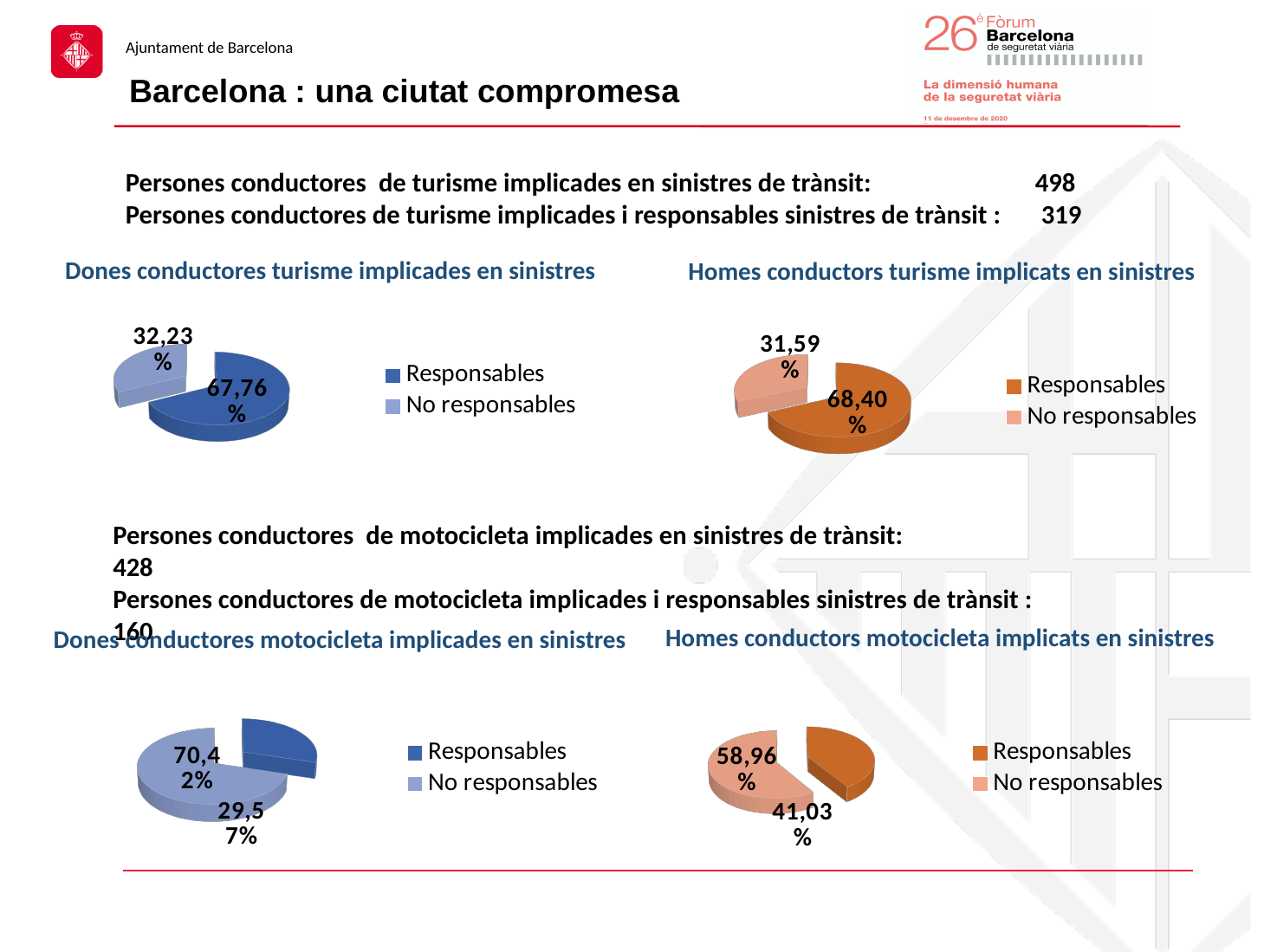
In the chart 'Dones conductores turisme implicades en sinistres', what share is labelled for Responsables? 67,76% In the chart 'Dones conductores turisme implicades en sinistres', which category has the smallest slice? No responsables In the chart 'Dones conductores motocicleta implicades en sinistres', what share is labelled for No responsables? 70,42% In the chart 'Dones conductores motocicleta implicades en sinistres', which is larger: Responsables or No responsables? No responsables In the chart 'Homes conductors turisme implicats en sinistres', what share is labelled for Responsables? 68,40% In the chart 'Homes conductors motocicleta implicats en sinistres', what share is labelled for Responsables? 41,03% In the chart 'Homes conductors motocicleta implicats en sinistres', which category has the largest slice? No responsables In the chart 'Homes conductors turisme implicats en sinistres', what share is labelled for No responsables? 31,59% How many entries does the legend of the chart 'Dones conductores turisme implicades en sinistres' list? 2 What type of chart is 'Homes conductors turisme implicats en sinistres'? Pie chart How many pie charts are shown on the slide? 4 In the chart 'Dones conductores turisme implicades en sinistres', what share is labelled for No responsables? 32,23%